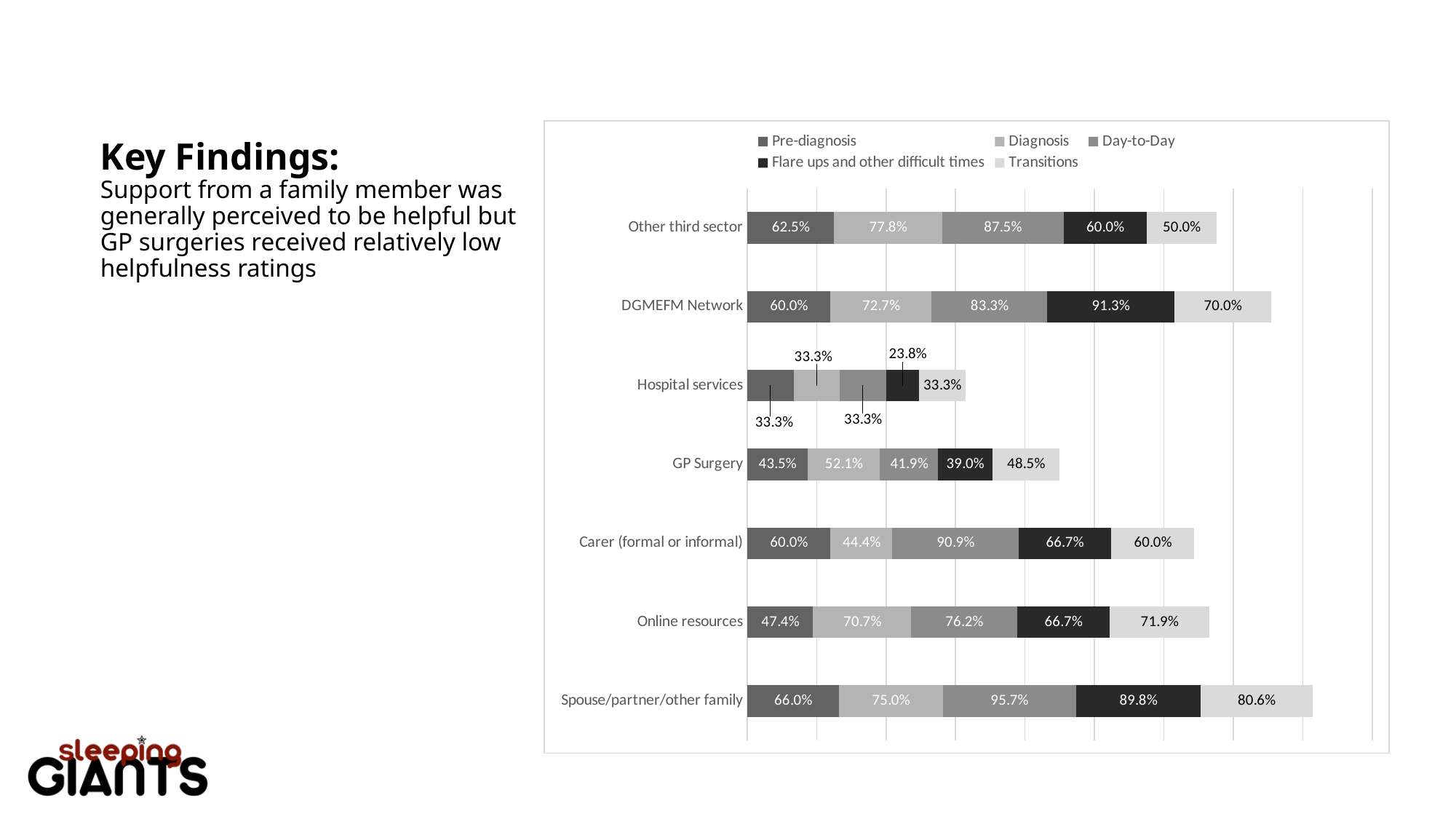
What is the Day-to-Day value for Spouse/partner/other family? 95.7% What is the Transitions value for GP Surgery? 48.5% Which category has the lowest value for Flare ups and other difficult times? Hospital services What is the total of the stacked bar for GP Surgery? 225.0% How many categories are shown on the chart? 7 What is the value for Flare ups and other difficult times for DGMEFM Network? 91.3% How many series does the legend list? 5 What is the Pre-diagnosis value for Online resources? 47.4% Which is larger, the Day-to-Day value for Carer (formal or informal) or for Online resources? Carer (formal or informal) Which category has the highest Day-to-Day value? Spouse/partner/other family What kind of chart is shown on the slide? Stacked bar chart What is the difference between the Transitions values for Spouse/partner/other family and Other third sector? 30.6 percentage points